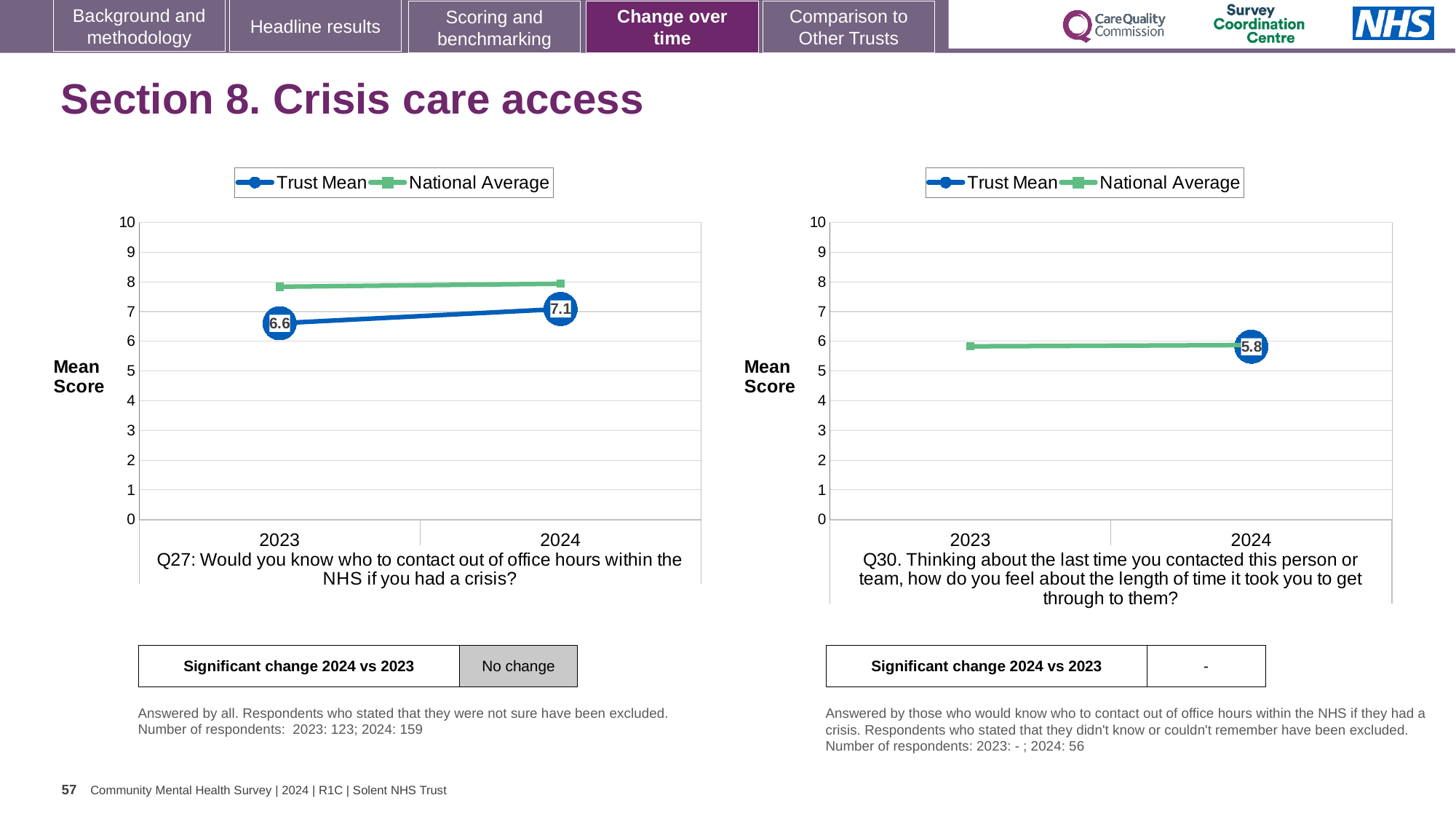
In the left chart (Q27), which year has the higher Trust Mean, 2023 or 2024? 2024 How many years are shown on the x axis of the left chart (Q27)? 2 In the left chart (Q27), does the Trust Mean rise or fall from 2023 to 2024? rise In the left chart (Q27), by how much did the Trust Mean change from 2023 to 2024? 0.5 How many series does the legend of the right chart (Q30) list? 2 In the left chart (Q27), what is the Trust Mean score for 2023? 6.6 What kind of chart is used on this slide? line chart In the right chart (Q30), what is the Trust Mean score for 2024? 5.8 In the left chart (Q27), is the National Average value for 2023 greater or less than 7? greater What is the label on the y axis of the left chart (Q27)? Mean Score In the left chart (Q27), what is the Trust Mean score for 2024? 7.1 In the left chart (Q27), is the Trust Mean value for 2023 greater or less than the National Average value for 2023? less